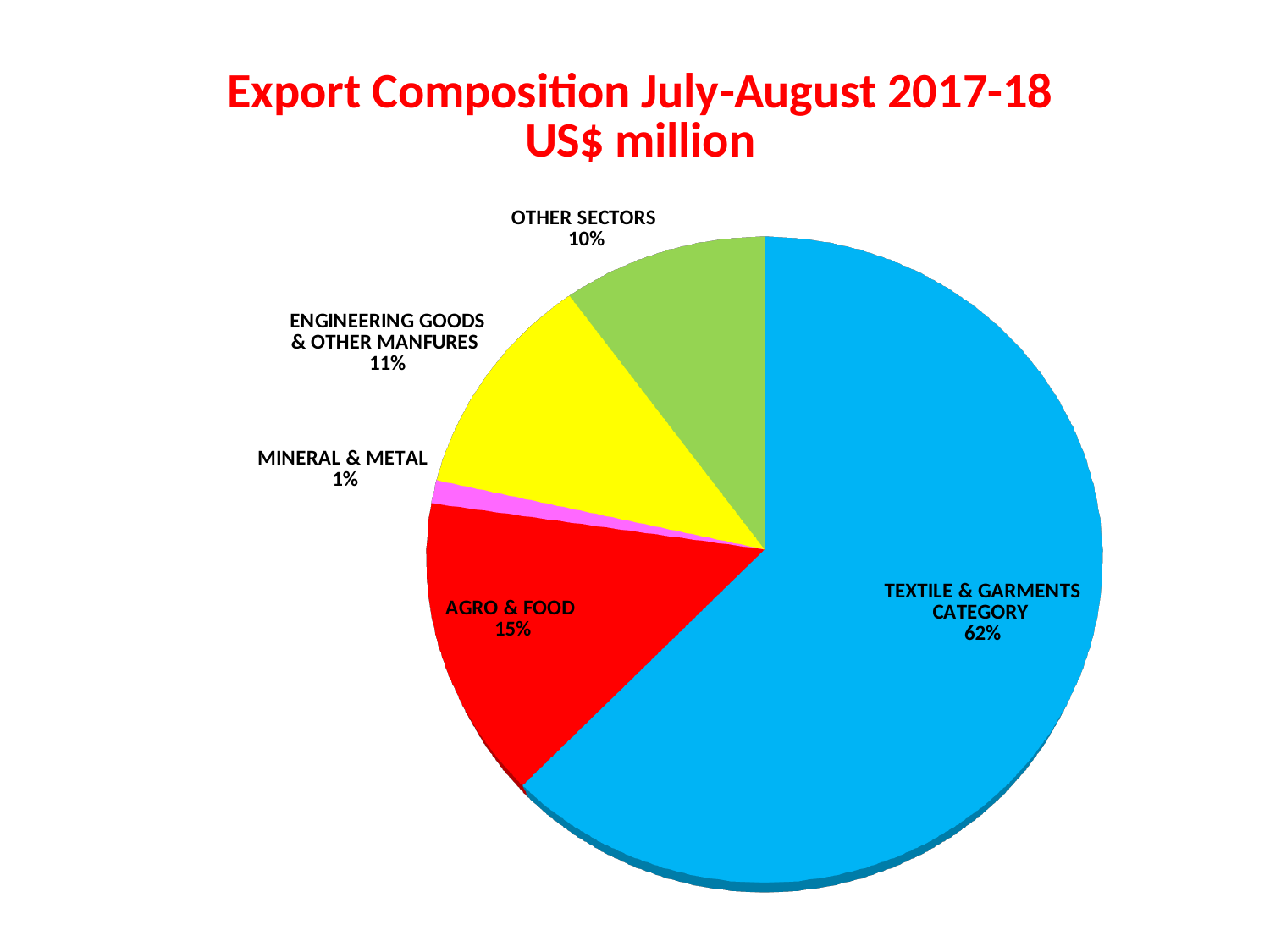
What is the difference in percentage points between Textile & Garments Category and Agro & Food? 47 What share of exports does the Textile & Garments Category account for? 62% What percentage is shown for Agro & Food? 15% What percentage is shown for Other Sectors? 10% Which is larger, the share for Agro & Food or the share for Other Sectors? Agro & Food Which category has the largest share of the pie? Textile & Garments Category What type of chart is shown on the slide? Pie chart What is the title of the chart? Export Composition July-August 2017-18 US$ million What percentage is shown for Engineering Goods & Other Manfures? 11% How many categories are shown in the pie chart? 5 Which category has the smallest share of the pie? Mineral & Metal What percentage is shown for Mineral & Metal? 1%